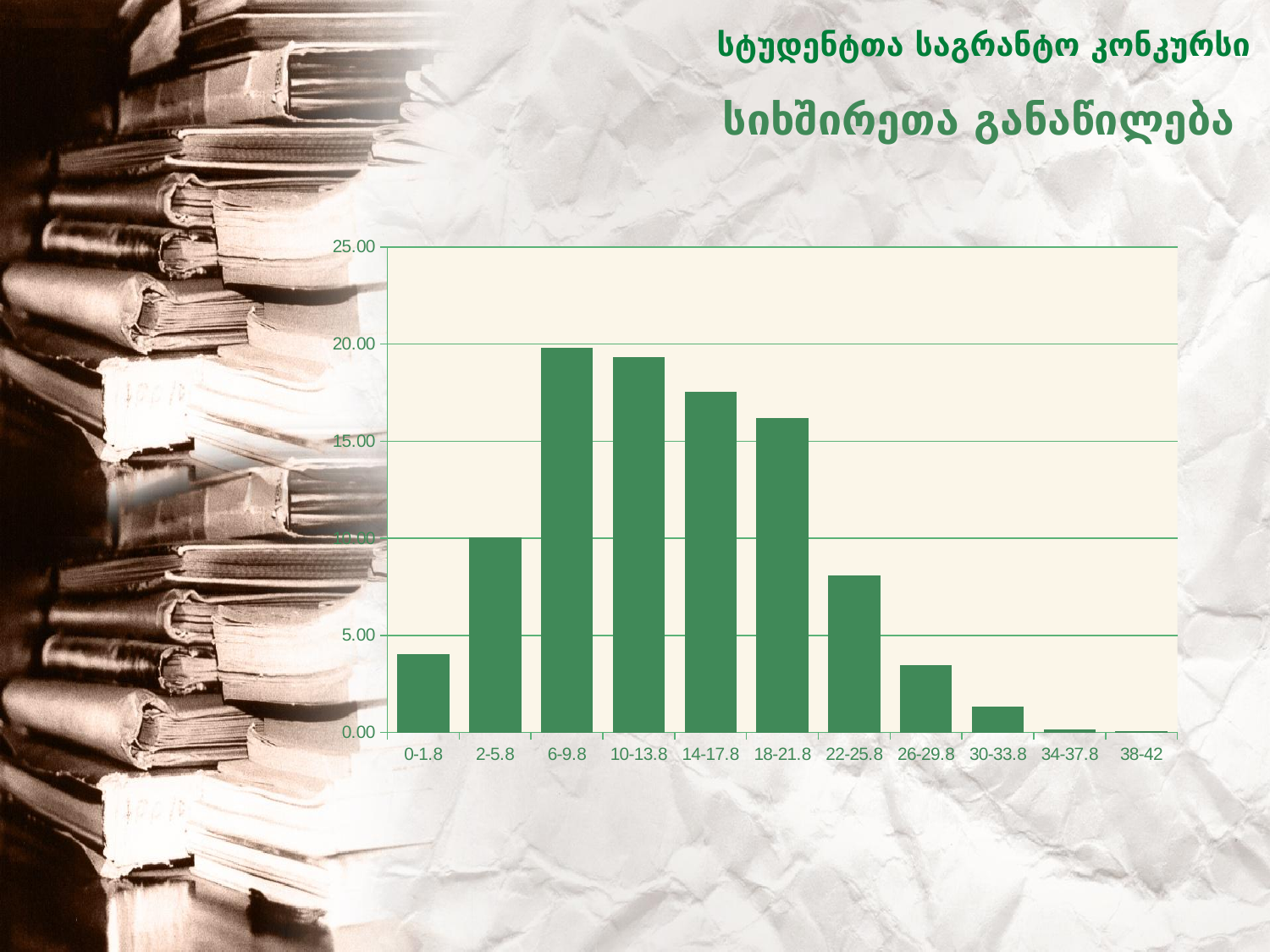
Which is larger, the value for 2-5.8 or the value for 22-25.8? 2-5.8 What kind of chart is shown on the slide? bar chart Which is larger, the value for 14-17.8 or the value for 18-21.8? 14-17.8 Is the value for 6-9.8 greater or less than 15.00? greater How many categories are shown on the x axis of the chart? 11 Is the value for 0-1.8 greater or less than 5.00? less Which category has the highest bar in the chart? 6-9.8 Which category has the lowest bar in the chart? 38-42 Is the value for 18-21.8 greater or less than 15.00? greater What colour are the bars in the chart? green